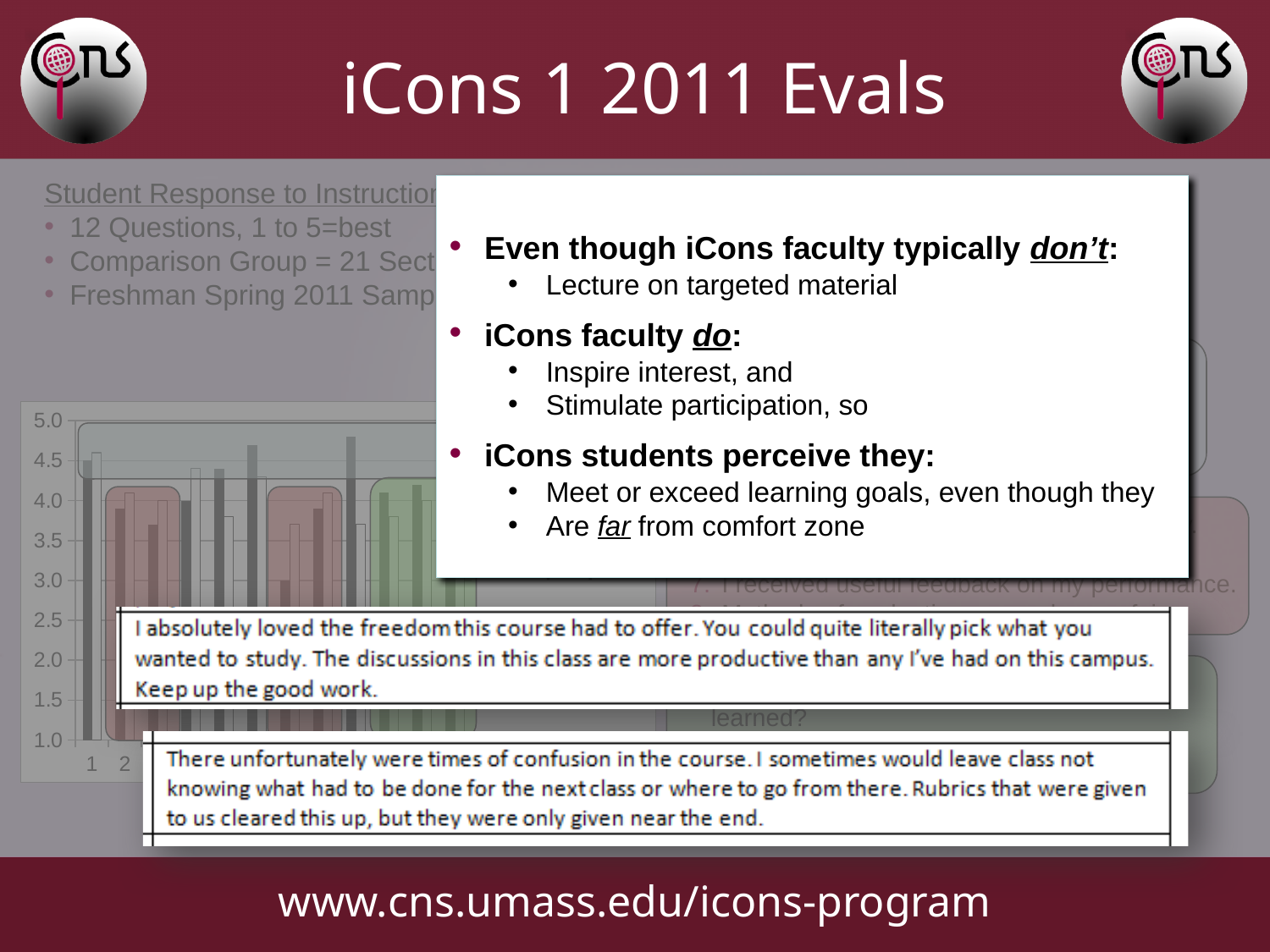
Is the value of the first (leftmost) bar for category 1 greater or less than 5.0? less What is the lowest value shown on the chart's vertical axis? 1.0 What is the highest value shown on the chart's vertical axis? 5.0 Is the value of the first (leftmost) bar for category 1 greater or less than 4.0? greater What kind of chart is shown on the slide? bar chart